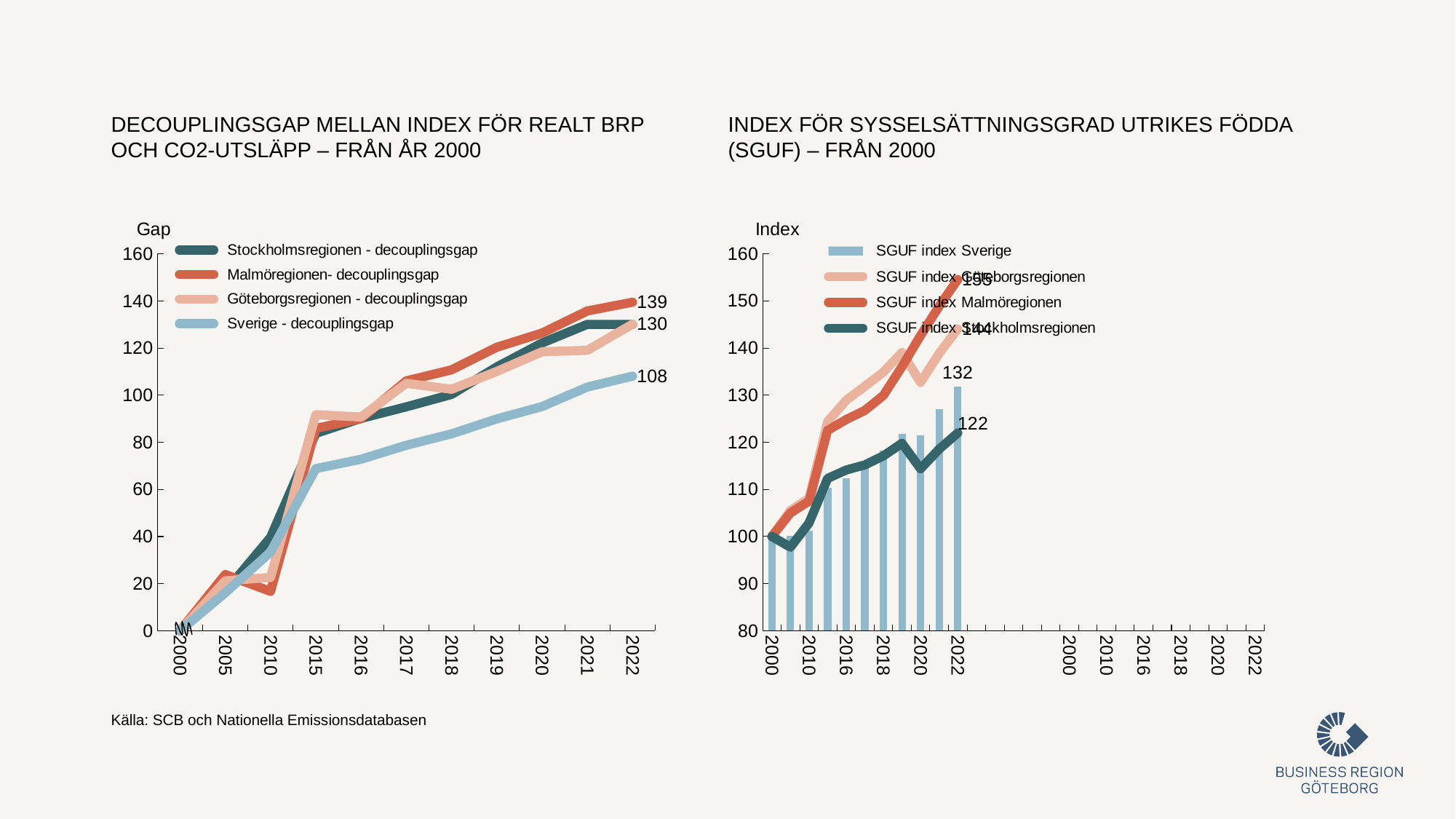
On the left chart (Decouplingsgap), what is the 2022 value for Malmöregionen - decouplingsgap? 139 On the right chart (Index för sysselsättningsgrad utrikes födda), what is the difference between the 2022 values for SGUF index Sverige and SGUF index Stockholmsregionen? 10 On the left chart (Decouplingsgap), is the 2015 value for Sverige - decouplingsgap greater or less than 80? less On the left chart (Decouplingsgap), which series has the lowest value in 2022? Sverige - decouplingsgap On the right chart (Index för sysselsättningsgrad utrikes födda), what is the 2022 value of SGUF index Sverige? 132 On the right chart (Index för sysselsättningsgrad utrikes födda), what is the 2022 value of SGUF index Stockholmsregionen? 122 On the right chart (Index för sysselsättningsgrad utrikes födda), which series is shown as bars rather than a line? SGUF index Sverige On the left chart (Decouplingsgap), what is the difference between the 2022 values for Malmöregionen and Sverige? 31 On the left chart (Decouplingsgap), which series has the highest value in 2022? Malmöregionen - decouplingsgap On the left chart (Decouplingsgap), does the Sverige - decouplingsgap line rise or fall from 2000 to 2022? rise On the left chart (Decouplingsgap), what is the 2022 value for Sverige - decouplingsgap? 108 On the left chart (Decouplingsgap), how many series does the legend list? 4